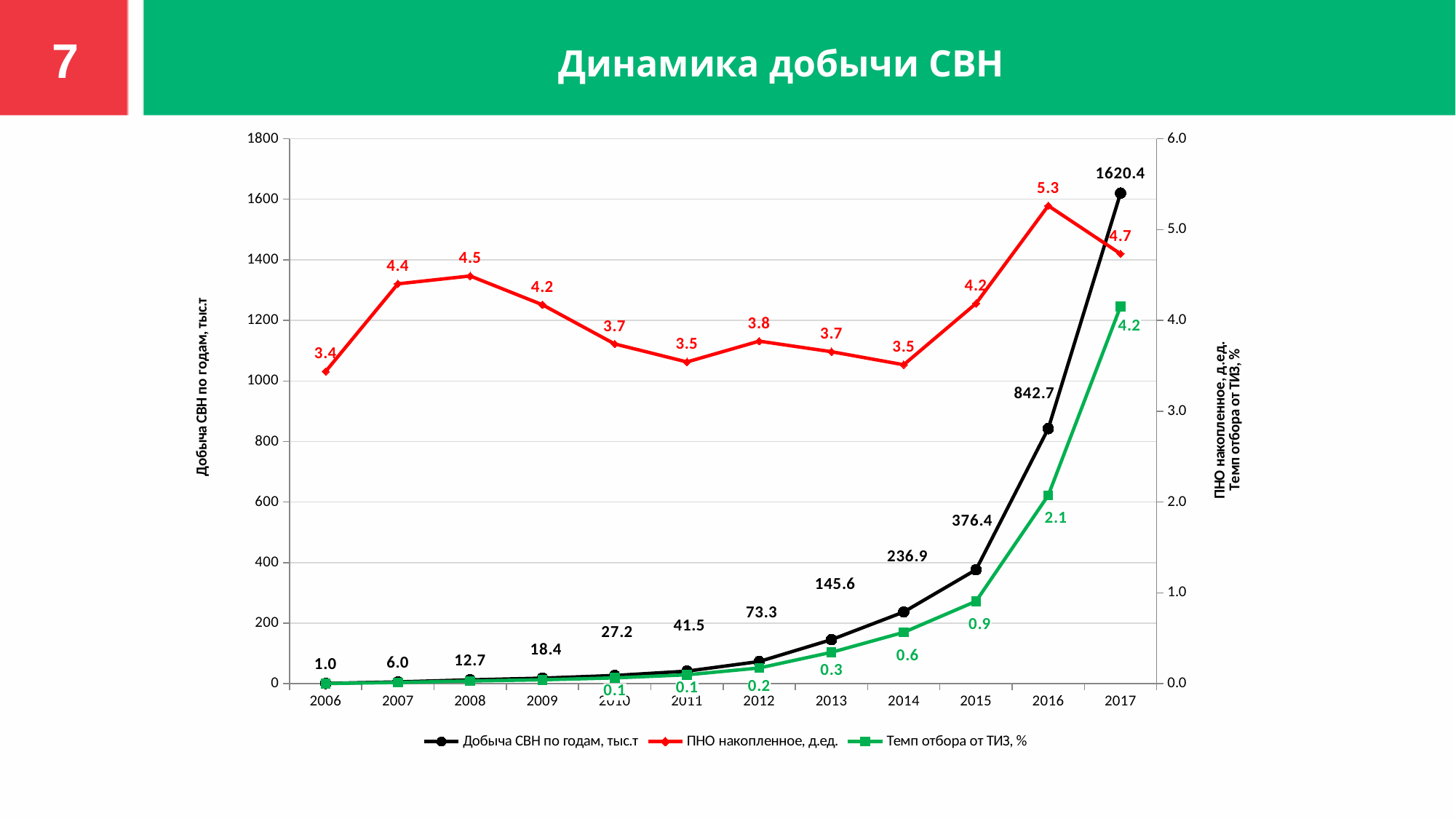
In which year is ПНО накопленное, д.ед. highest? 2016 In which year is ПНО накопленное, д.ед. lowest? 2006 What is the difference between Добыча СВН по годам, тыс.т in 2017 and in 2016? 777.7 How many series does the legend list? 3 What is the value of ПНО накопленное, д.ед. for 2016? 5.3 What is the value of Добыча СВН по годам, тыс.т for 2017? 1620.4 How many years are shown on the x axis? 12 Which is larger: ПНО накопленное, д.ед. in 2008 or in 2009? 2008 Does Добыча СВН по годам, тыс.т rise or fall from 2006 to 2017? rise What is the value of Темп отбора от ТИЗ, % for 2015? 0.9 What is the title of the chart? Динамика добычи СВН What kind of chart is shown on the slide? line chart